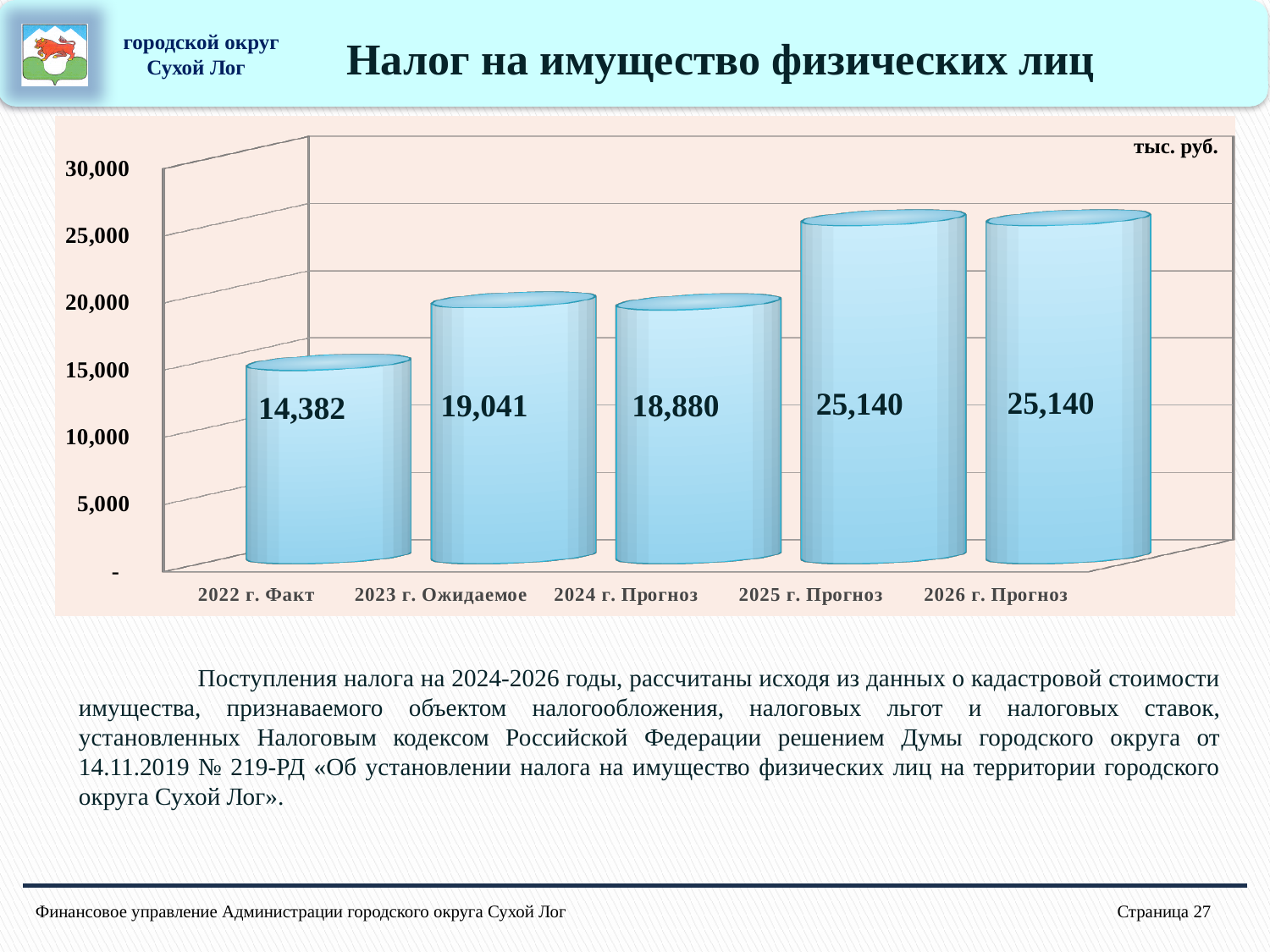
What unit is indicated in the top right corner of the chart? тыс. руб. What is the value for 2024 г. Прогноз? 18,880 What is the value for 2023 г. Ожидаемое? 19,041 What is the difference between the values for 2023 г. Ожидаемое and 2022 г. Факт? 4,659 What kind of chart is shown on the slide? Bar chart What is the highest value shown on the chart? 25,140 What is the value for 2025 г. Прогноз? 25,140 Which is larger, the value for 2023 г. Ожидаемое or 2024 г. Прогноз? 2023 г. Ожидаемое What is the difference between the values for 2025 г. Прогноз and 2024 г. Прогноз? 6,260 How many categories are shown on the chart? 5 What is the value for 2022 г. Факт? 14,382 Which category has the lowest value? 2022 г. Факт